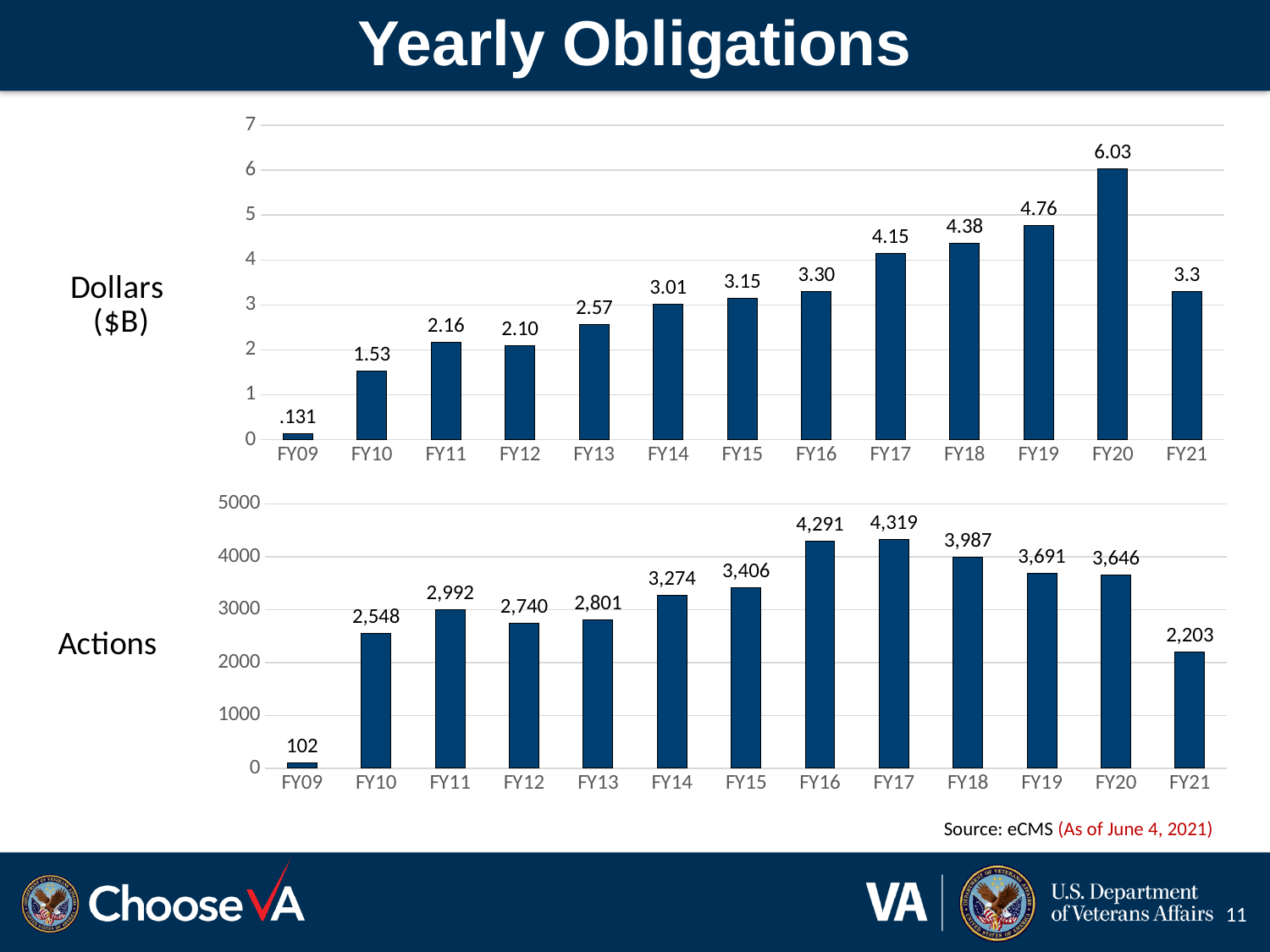
In the Actions chart, what is the difference between the FY16 and FY15 values? 885 How many fiscal years are shown in the Dollars ($B) chart? 13 In the Dollars ($B) chart, do the values rise or fall from FY16 to FY20? Rise In the Actions chart, what is the value for FY21? 2,203 In the Dollars ($B) chart, what is the value for FY09? .131 In the Actions chart, what is the value for FY17? 4,319 In the Actions chart, which fiscal year has the lowest value? FY09 In the Dollars ($B) chart, which fiscal year has the highest value? FY20 In the Dollars ($B) chart, what is the difference between the FY20 and FY21 values? 2.73 In the Dollars ($B) chart, what is the value for FY20? 6.03 What kind of chart is the Actions chart? Bar chart In the Actions chart, which is larger, the value for FY18 or the value for FY19? FY18